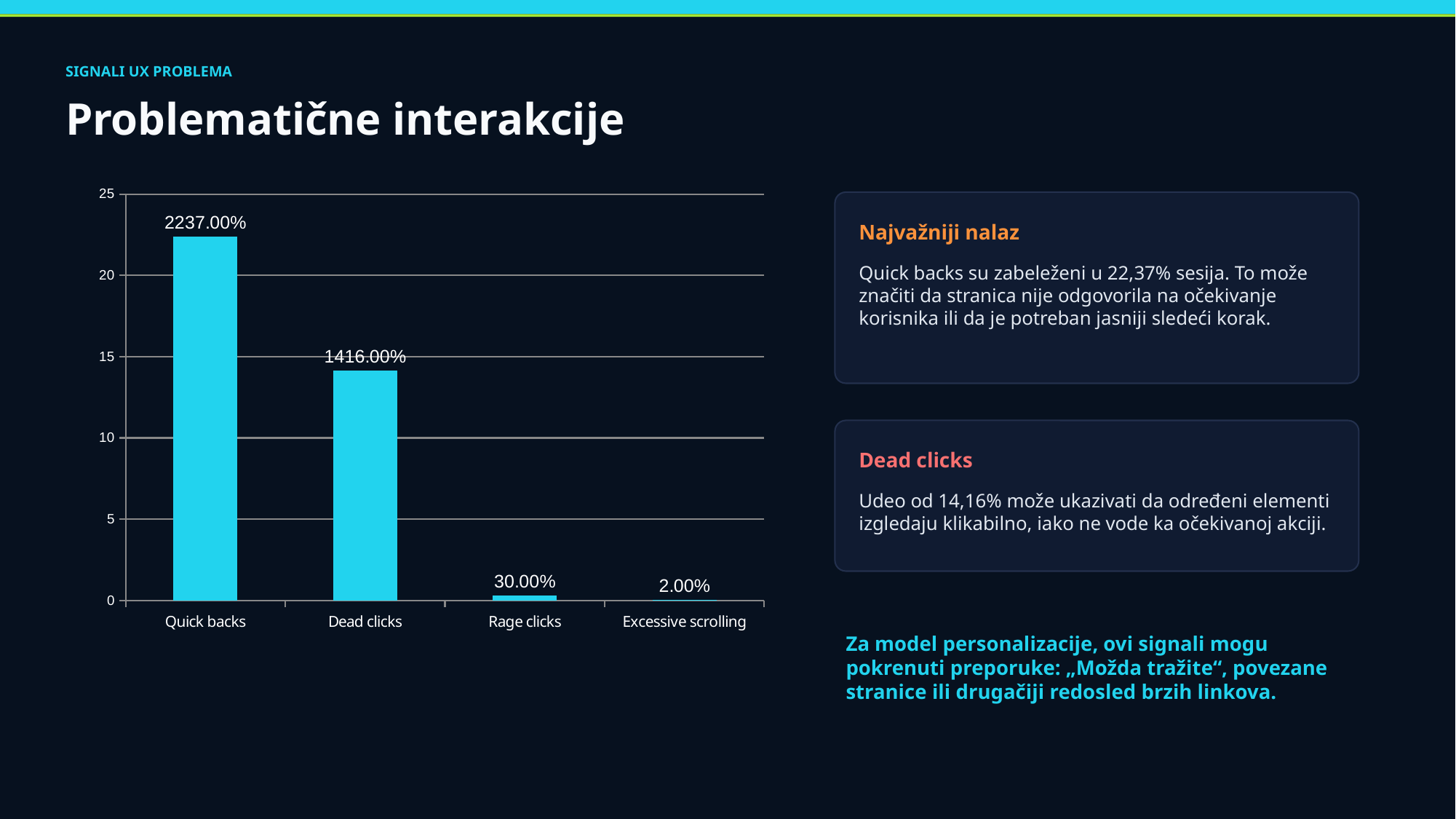
How many categories are shown on the x axis? 4 Which is larger, the bar for Dead clicks or the bar for Rage clicks? Dead clicks Which category has the lowest bar? Excessive scrolling What is the data label shown for Excessive scrolling? 2.00% Which category has the highest bar? Quick backs Do the bar values rise or fall from left to right along the x axis? Fall Is the bar for Dead clicks greater or less than 15 on the axis? less What is the data label shown for Quick backs? 2237.00% What kind of chart is shown on the slide? Bar chart What is the data label shown for Rage clicks? 30.00% Is the bar for Quick backs greater or less than 20 on the axis? greater What is the data label shown for Dead clicks? 1416.00%